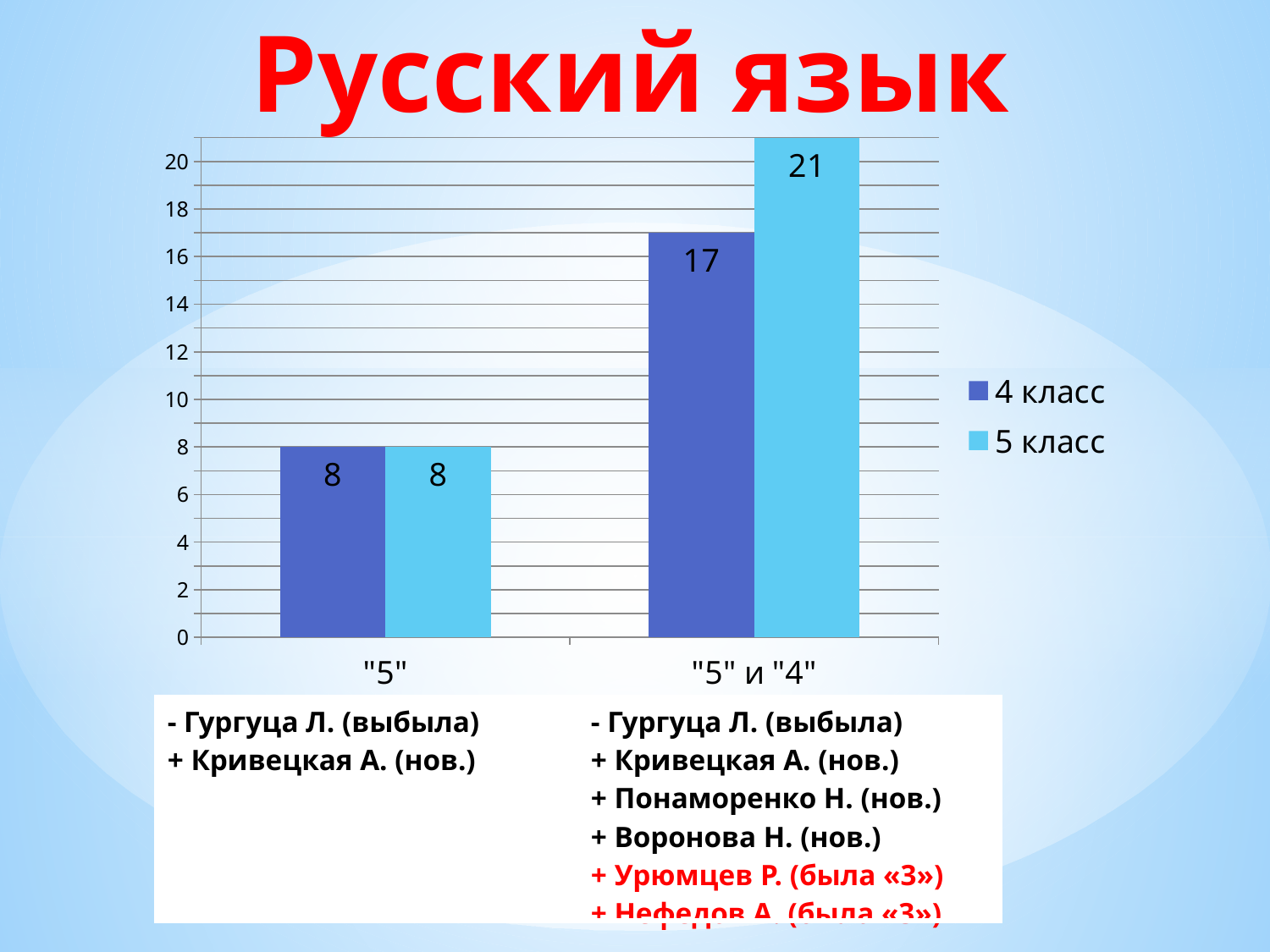
What is the value for "5 класс" in the "5" и "4" category? 21 How many series does the legend list? 2 What is the value for "5 класс" in the "5" category? 8 What kind of chart is shown on the slide? bar chart What is the title of the slide above the chart? Русский язык Which category has the lowest value for "4 класс"? "5" In the "5" и "4" category, which series has the larger value, "4 класс" or "5 класс"? 5 класс What is the value for "4 класс" in the "5" и "4" category? 17 Which category has the highest value for "5 класс"? "5" и "4" What is the difference between the "5 класс" and "4 класс" values in the "5" и "4" category? 4 How many categories are shown on the x axis? 2 What is the value for "4 класс" in the "5" category? 8